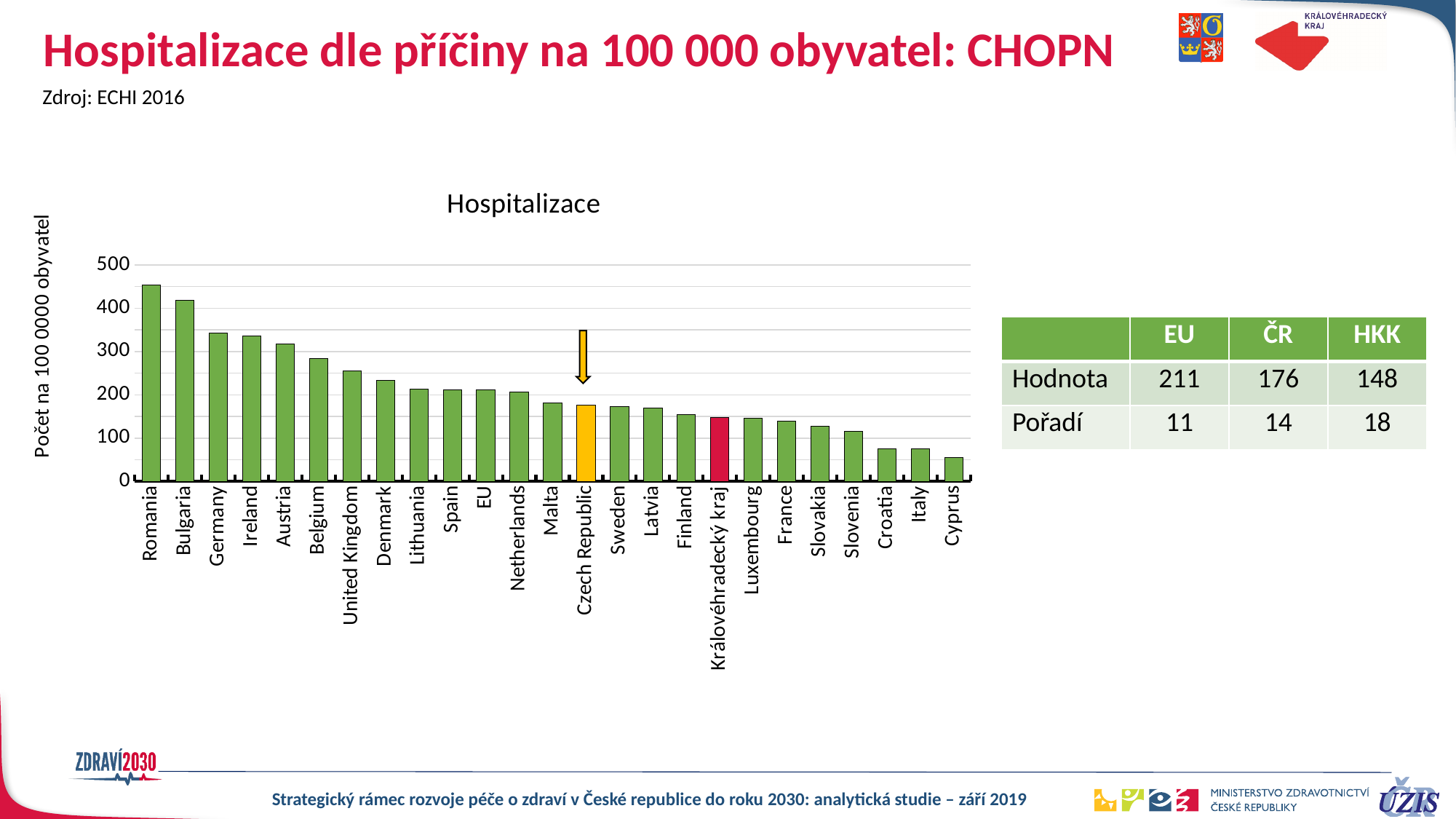
What is the title of the chart? Hospitalizace What kind of chart is shown on the slide? bar chart According to the table, what is the value for the EU? 211 What is the difference between the EU value and the ČR value shown in the table? 35 Which category has the lowest value in the chart? Cyprus Which country has the highest hospitalization rate in the chart? Romania Do the values rise or fall from left to right along the x axis? fall Is the value for Romania greater or less than 400? greater How many bars (categories) are plotted in the chart? 25 Is the value for Cyprus greater or less than 100? less According to the table, what is the value for ČR (Czech Republic)? 176 According to the table, what is the value for HKK (Královéhradecký kraj)? 148